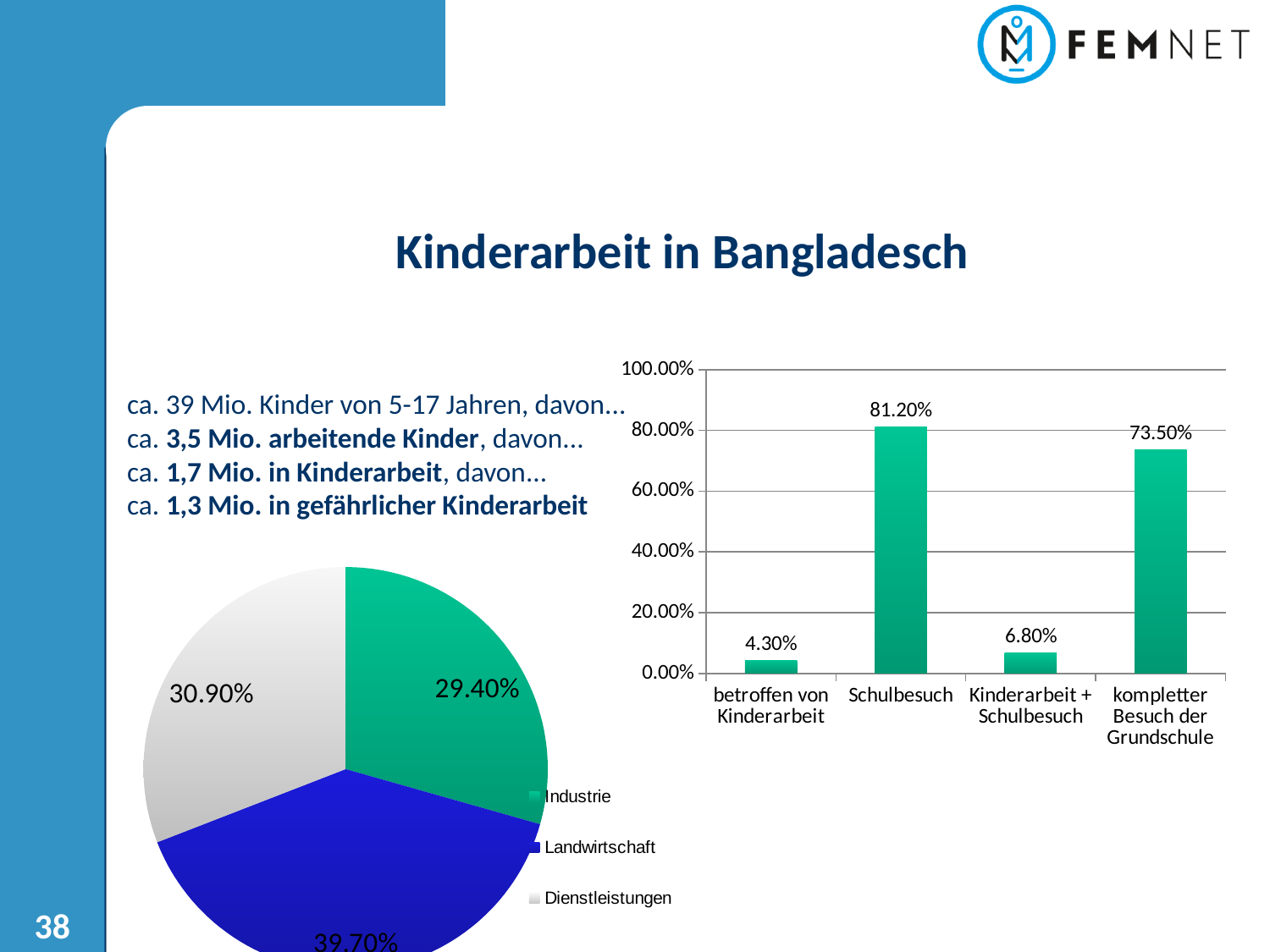
In the bar chart on the right, which is larger: Kinderarbeit + Schulbesuch or betroffen von Kinderarbeit? Kinderarbeit + Schulbesuch In the bar chart on the right, which category has the lowest value? betroffen von Kinderarbeit How many categories are shown in the bar chart on the right? 4 What type of chart is shown on the right side of the slide? Bar chart In the pie chart at the bottom left, what is the share for Landwirtschaft? 39.70% In the bar chart on the right, what is the value for kompletter Besuch der Grundschule? 73.50% How many entries does the legend of the pie chart at the bottom left list? 3 In the bar chart on the right, what is the difference between Schulbesuch and kompletter Besuch der Grundschule? 7.70% In the pie chart at the bottom left, which slice is the largest? Landwirtschaft In the bar chart on the right, which category has the highest value? Schulbesuch In the bar chart on the right, what is the value for Schulbesuch? 81.20% In the bar chart on the right, what is the value for betroffen von Kinderarbeit? 4.30%